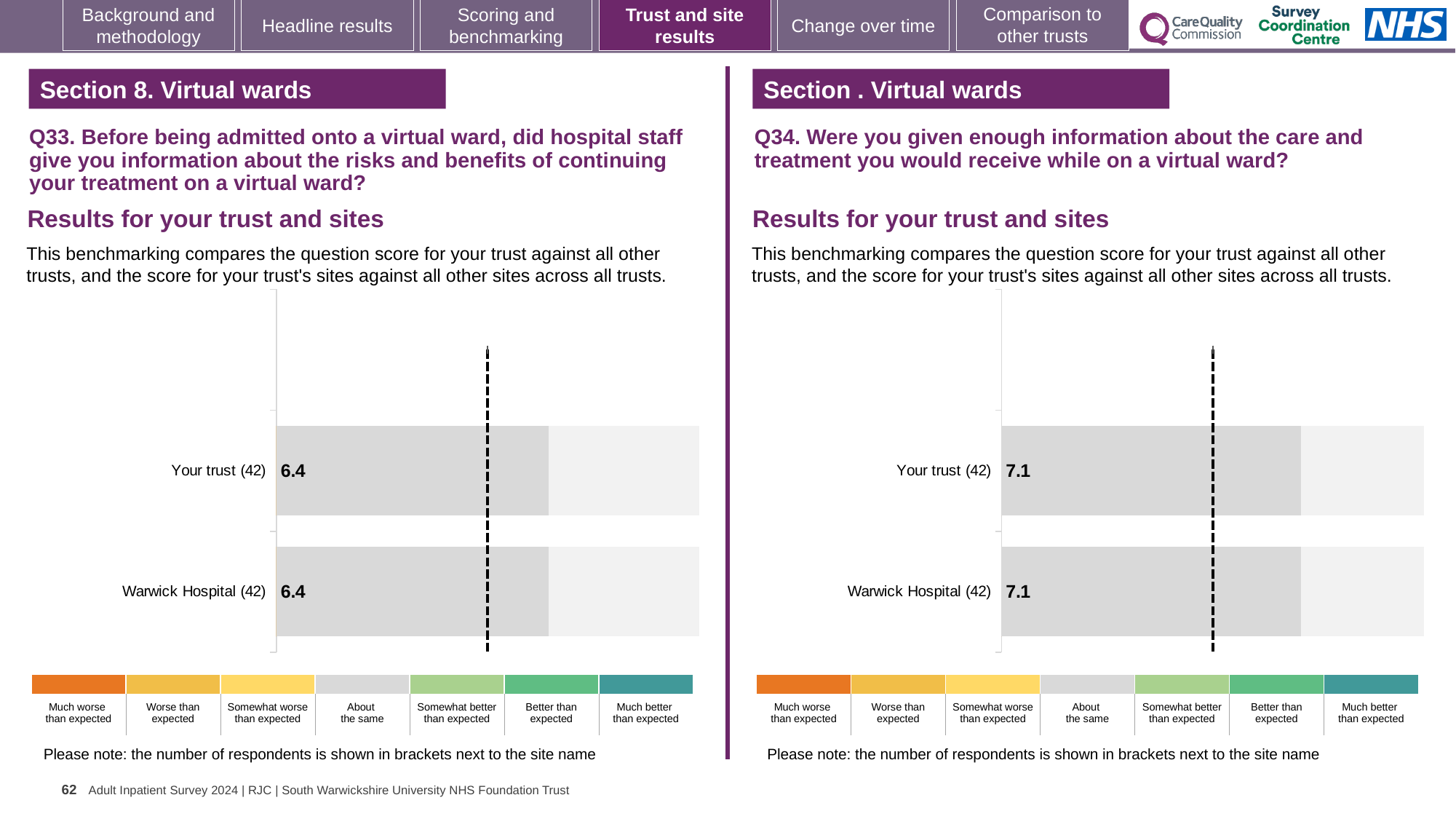
What kind of chart is used in the Q33 chart on the left? Bar chart In the Q34 chart on the right, what is the score for Your trust? 7.1 In the Q33 chart on the left, how many respondents are shown in brackets for Warwick Hospital? 42 In the Q33 chart on the left, what is the score for Warwick Hospital? 6.4 In the Q34 chart on the right, which benchmark category does the grey colour of the bars correspond to in the colour key? About the same In the Q33 chart on the left, what is the score for Your trust? 6.4 How many sites or trusts are plotted in the Q33 chart on the left? 2 What is the difference between the Your trust score in the Q34 chart on the right and the Your trust score in the Q33 chart on the left? 0.7 In the Q34 chart on the right, what is the score for Warwick Hospital? 7.1 Is the score for Your trust higher in the Q33 chart on the left or the Q34 chart on the right? Q34 chart on the right How many benchmark categories does the colour key below the Q34 chart on the right list? 7 How many sites or trusts are plotted in the Q34 chart on the right? 2